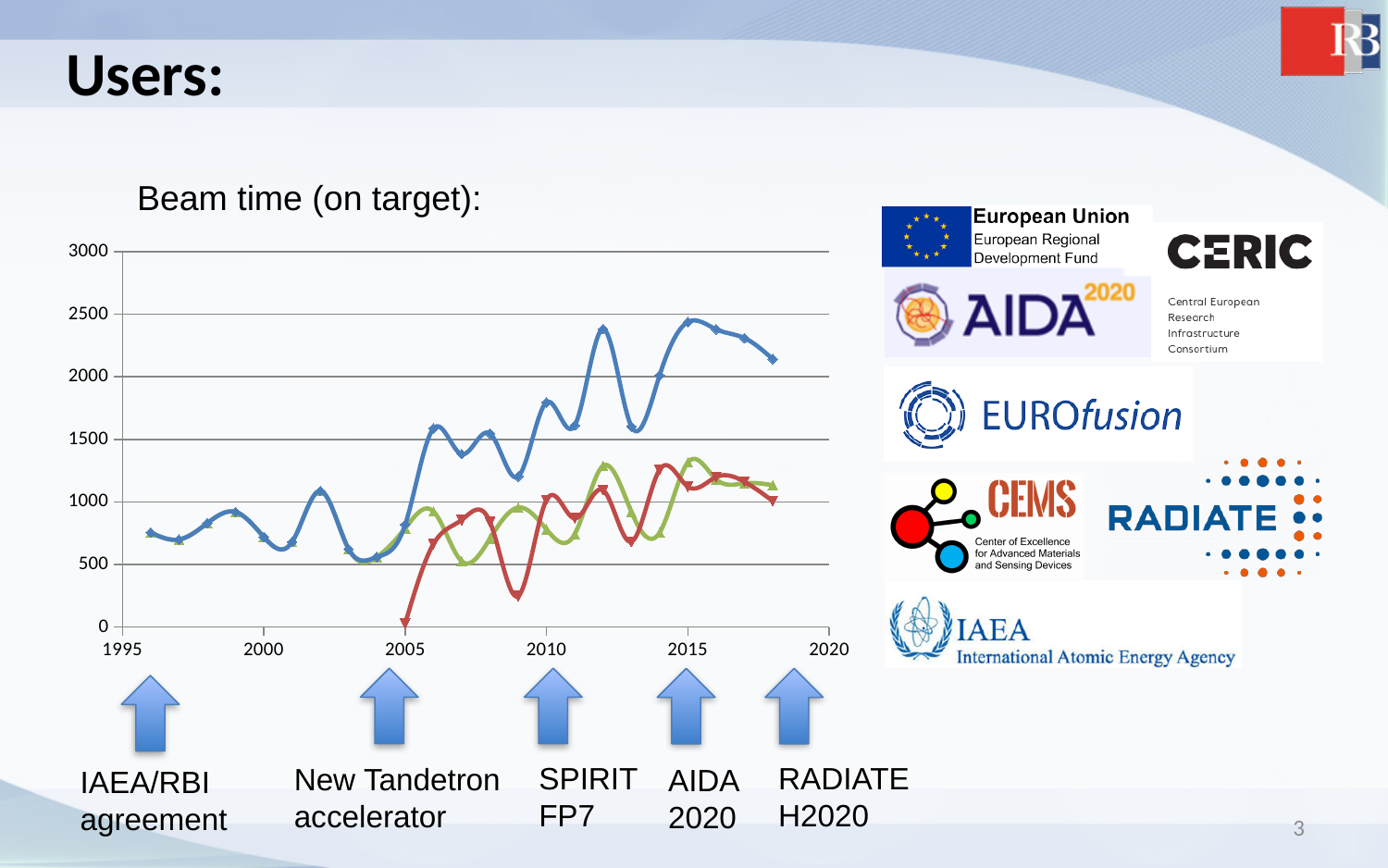
How many lines are plotted in the beam time chart? 3 What is the highest value shown on the vertical axis of the beam time chart? 3000 Is the value of the green line in 2004 greater or less than 1000? less Is the value of the blue line in 1996 greater or less than 1000? less What kind of chart is shown under the heading "Beam time (on target):"? line chart In 2015, which line has the larger value, the blue line or the red line? blue line In 2010, which line has the larger value, the blue line or the green line? blue line What range of years does the horizontal axis of the beam time chart cover? 1995 to 2020 Is the value of the blue line in 2018 greater or less than 2000? greater Does the blue line rise or fall overall from 1996 to 2018? rise